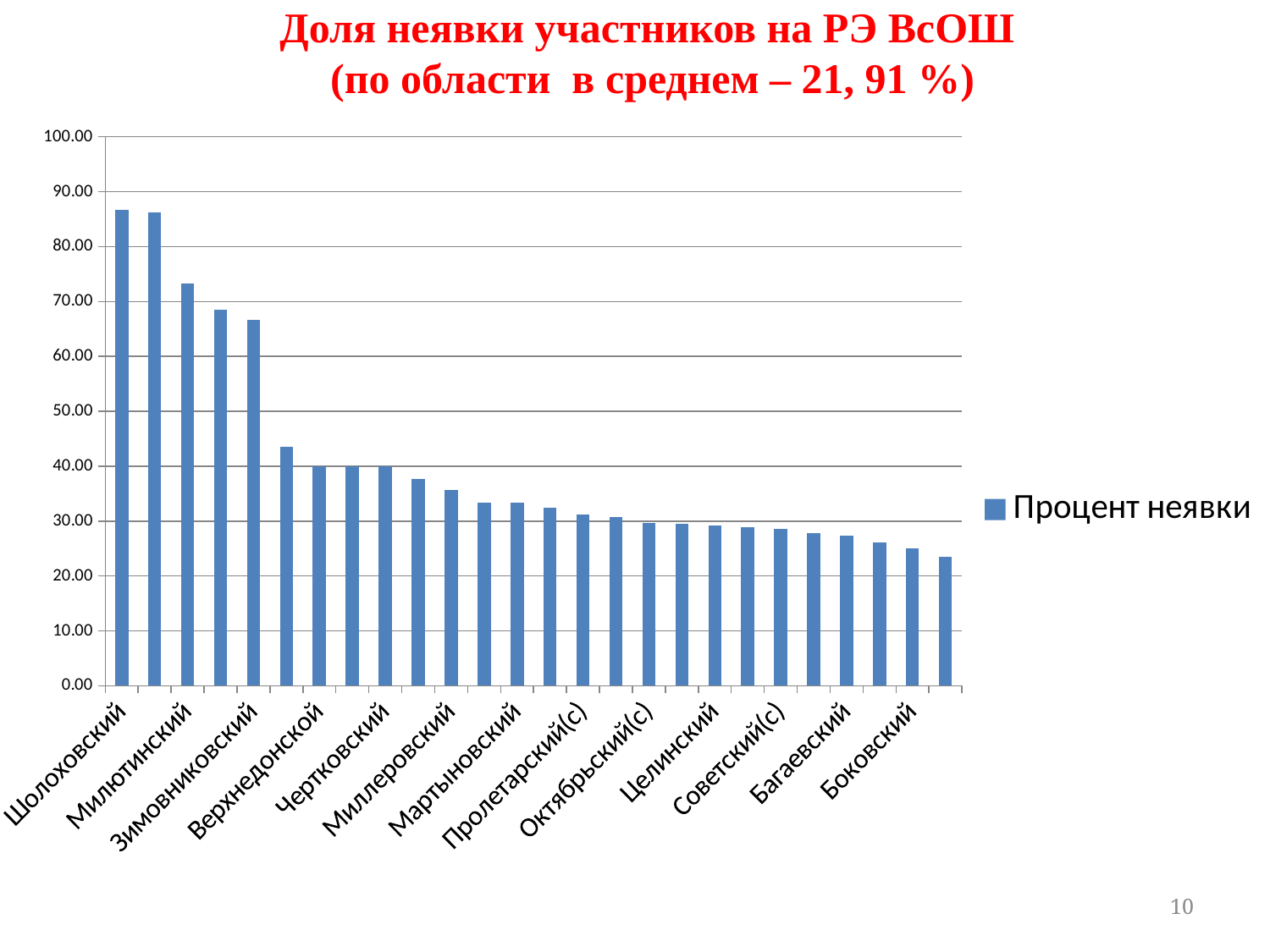
What kind of chart is shown on the slide? Bar chart Is the value for Миллеровский greater or less than 40.00? less Is the value for Милютинский greater or less than 70.00? greater How many series does the legend list? 1 Which category has the highest value? Шолоховский What regional average is stated in the chart title? 21, 91 % Is the value for Шолоховский greater or less than 80.00? greater What is the name of the series shown in the legend? Процент неявки Do the values rise or fall from left to right along the x axis? Fall Which has the larger value, Милютинский or Зимовниковский? Милютинский